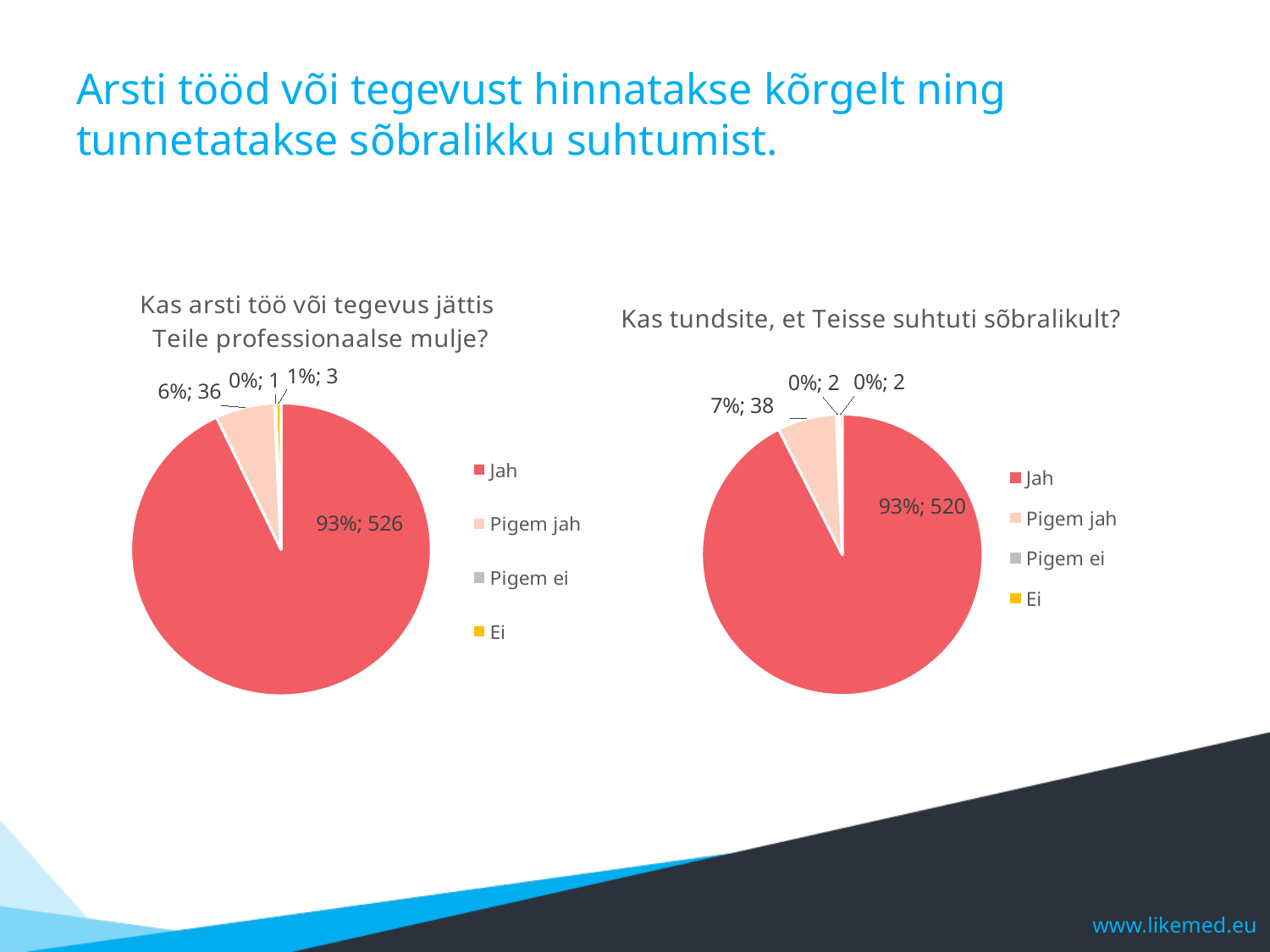
In the left chart, 'Kas arsti töö või tegevus jättis Teile professionaalse mulje?', what is the count shown for 'Ei'? 3 In the right chart, 'Kas tundsite, et Teisse suhtuti sõbralikult?', what is the count shown for 'Jah'? 520 In the right chart, 'Kas tundsite, et Teisse suhtuti sõbralikult?', what colour is the 'Jah' slice? red In the right chart, 'Kas tundsite, et Teisse suhtuti sõbralikult?', what is the difference between the counts for 'Jah' and 'Pigem jah'? 482 In the right chart, 'Kas tundsite, et Teisse suhtuti sõbralikult?', which category has the largest share? Jah What type of chart is used on the left chart, 'Kas arsti töö või tegevus jättis Teile professionaalse mulje?'? pie chart In the left chart, 'Kas arsti töö või tegevus jättis Teile professionaalse mulje?', how many categories does the legend list? 4 In the left chart, 'Kas arsti töö või tegevus jättis Teile professionaalse mulje?', which category has the smallest count? Pigem ei In the left chart, 'Kas arsti töö või tegevus jättis Teile professionaalse mulje?', what percentage share does 'Pigem jah' have? 6% Which chart has the larger count for 'Jah': the left chart or the right chart? the left chart In the right chart, 'Kas tundsite, et Teisse suhtuti sõbralikult?', what percentage share does 'Pigem jah' have? 7% In the left chart, 'Kas arsti töö või tegevus jättis Teile professionaalse mulje?', what is the count shown for 'Jah'? 526